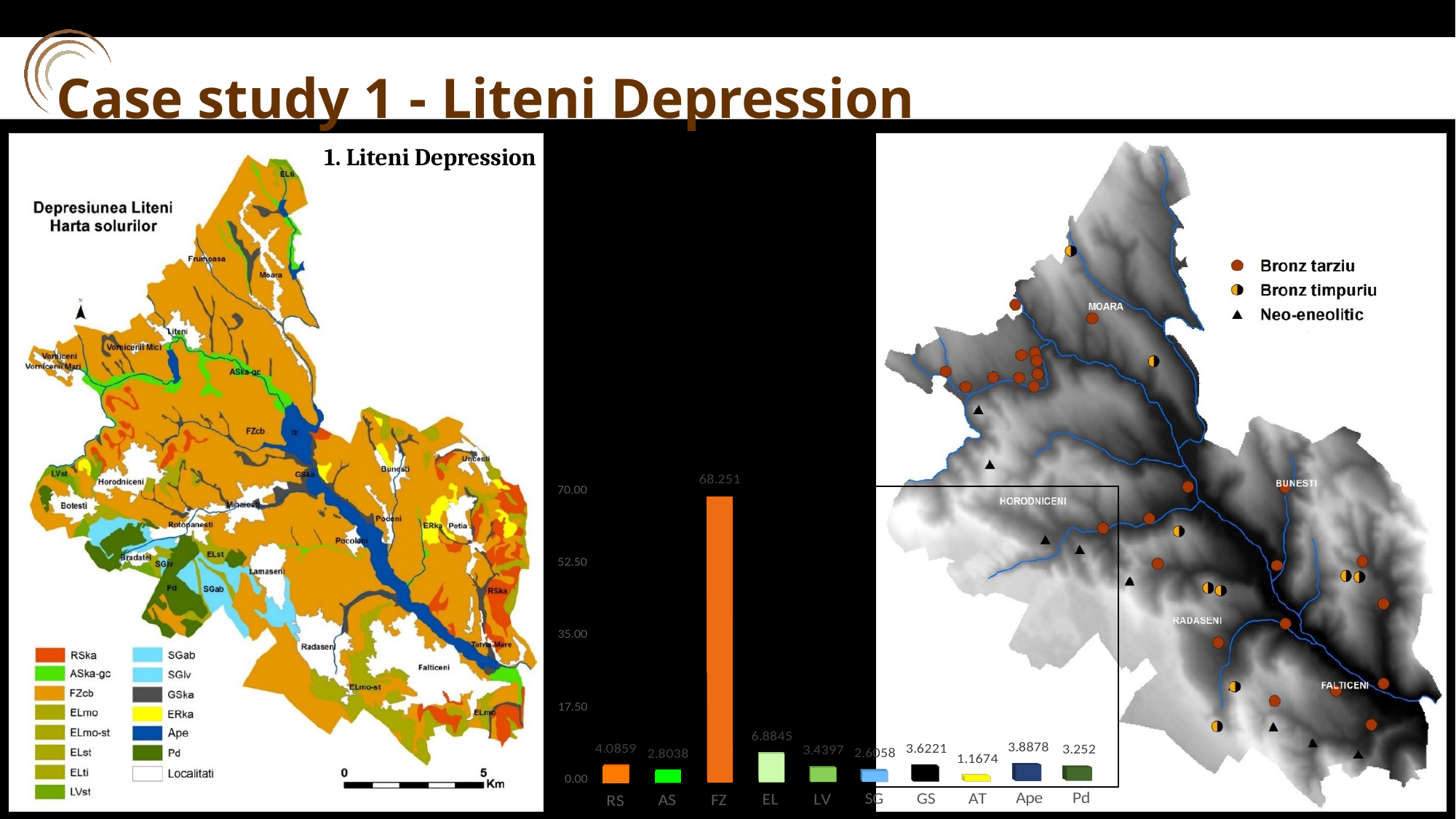
What is the difference between the values for FZ and EL in the bar chart? 61.3665 What is the value for Ape in the bar chart? 3.8878 What is the value for SG in the bar chart? 2.6058 Is the value for FZ in the bar chart greater or less than 52.50? greater What is the value for FZ in the bar chart? 68.251 How many categories are plotted in the bar chart? 10 Which category has the lowest value in the bar chart? AT Which category has the highest value in the bar chart? FZ What is the value for EL in the bar chart? 6.8845 What is the value for AT in the bar chart? 1.1674 Which is larger in the bar chart, the value for RS or the value for AS? RS What type of chart is shown in the middle of the slide? bar chart